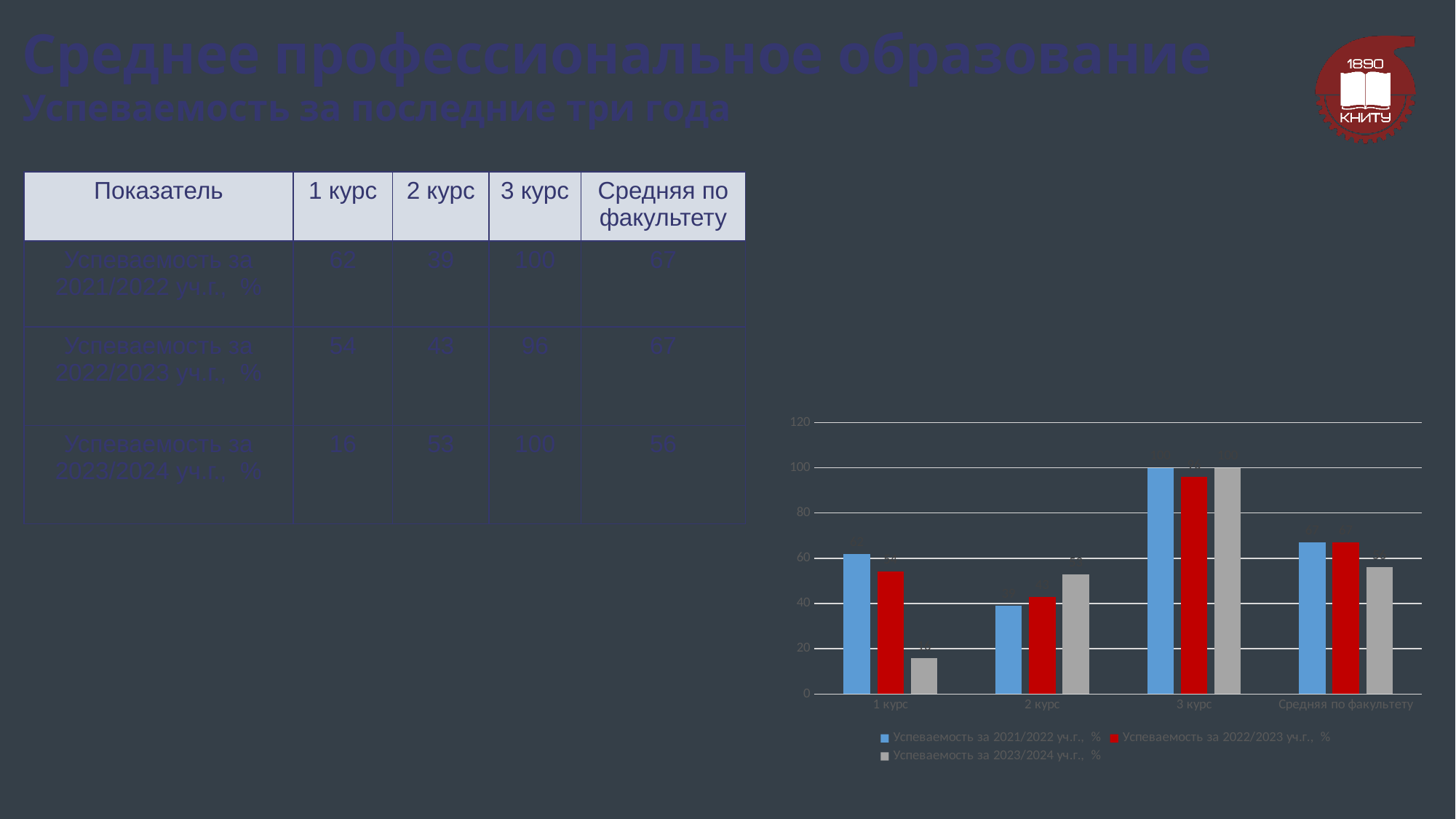
Which colour represents the series Успеваемость за 2022/2023 уч.г., % in the chart? red Is the value for 3 курс in the series Успеваемость за 2022/2023 уч.г., % greater or less than 80? greater Is the value for Средняя по факультету in the series Успеваемость за 2021/2022 уч.г., % greater or less than 60? greater Which category has the highest value in the series Успеваемость за 2022/2023 уч.г., %? 3 курс What is the value for 3 курс in the series Успеваемость за 2023/2024 уч.г., %? 100 How many categories are shown on the x axis of the chart? 4 For 1 курс, which series has the larger value: Успеваемость за 2021/2022 уч.г., % or Успеваемость за 2023/2024 уч.г., %? Успеваемость за 2021/2022 уч.г., % What kind of chart is shown on the slide? bar chart What is the value for 3 курс in the series Успеваемость за 2021/2022 уч.г., %? 100 How many series does the chart legend list? 3 Which category has the lowest value in the series Успеваемость за 2023/2024 уч.г., %? 1 курс Is the value for 1 курс in the series Успеваемость за 2023/2024 уч.г., % greater or less than 20? less